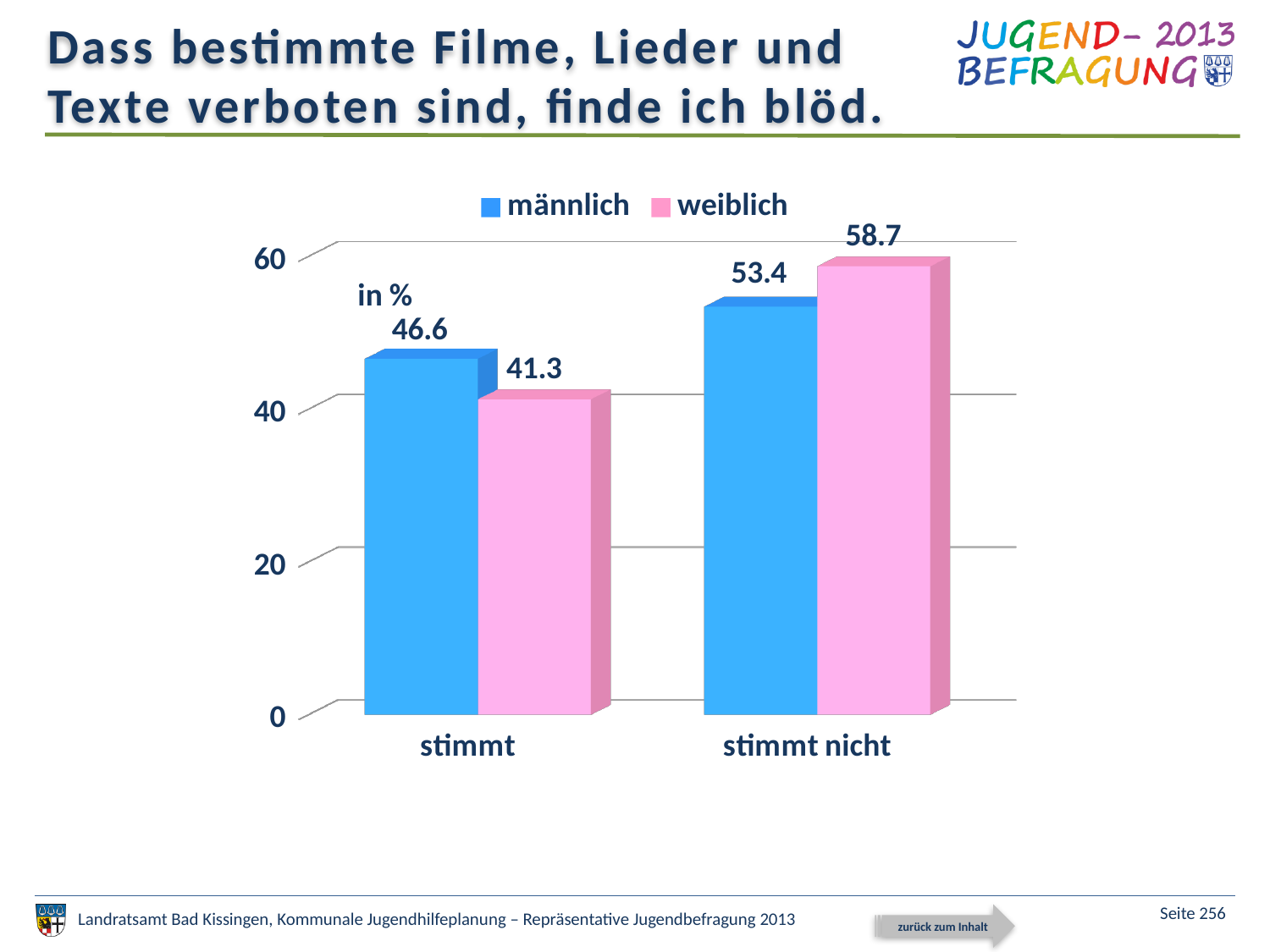
How many categories are shown on the x axis? 2 What is the value for männlich in the stimmt nicht category? 53.4 What is the value for weiblich in the stimmt nicht category? 58.7 Which bar has the highest value on the chart? weiblich, stimmt nicht What is the difference between the weiblich and männlich values in the stimmt nicht category? 5.3 Which is larger in the stimmt category, männlich or weiblich? männlich How many series does the legend list? 2 What kind of chart is shown on the slide? bar chart What is the value for weiblich in the stimmt category? 41.3 Which bar has the lowest value on the chart? weiblich, stimmt What is the value for männlich in the stimmt category? 46.6 What is the difference between the männlich and weiblich values in the stimmt category? 5.3